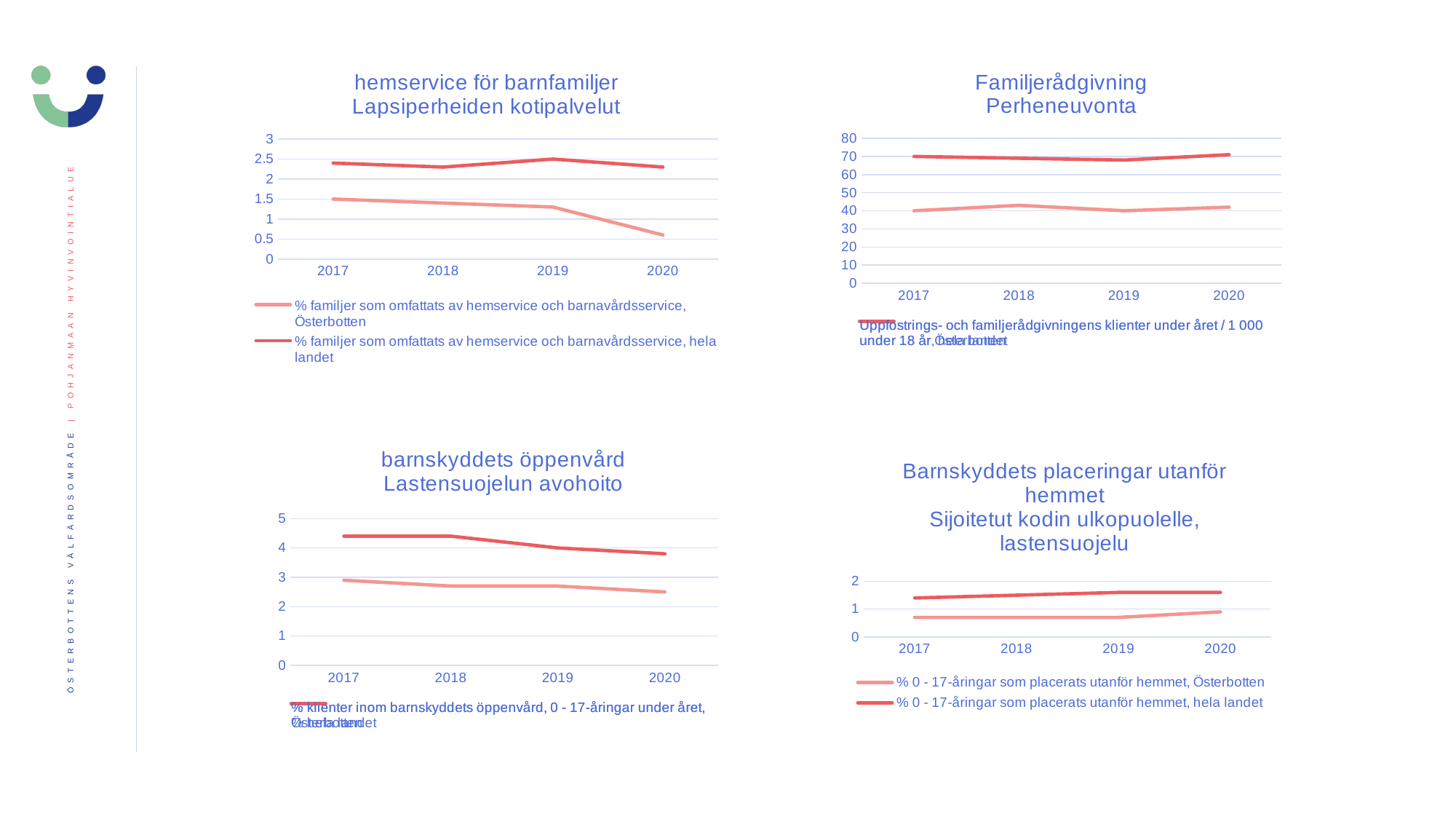
In the 'hemservice för barnfamiljer / Lapsiperheiden kotipalvelut' chart, does the Österbotten series rise or fall from 2017 to 2020? fall In the 'Familjerådgivning / Perheneuvonta' chart, is the value of the lower (light red) line for 2019 greater or less than 50? less What kind of chart is the 'hemservice för barnfamiljer / Lapsiperheiden kotipalvelut' chart? line chart How many series does the legend of the 'hemservice för barnfamiljer / Lapsiperheiden kotipalvelut' chart list? 2 In the 'Familjerådgivning / Perheneuvonta' chart, is the value of the upper (dark red) line for 2017 greater or less than 60? greater In the 'barnskyddets öppenvård / Lastensuojelun avohoito' chart, does the hela landet (dark red) series rise or fall from 2017 to 2020? fall In the 'hemservice för barnfamiljer / Lapsiperheiden kotipalvelut' chart, which year has the lowest value for Österbotten? 2020 In the 'barnskyddets öppenvård / Lastensuojelun avohoito' chart, is the hela landet (dark red) value for 2020 greater or less than 4? less In the 'hemservice för barnfamiljer / Lapsiperheiden kotipalvelut' chart, how many years are plotted on the x axis? 4 In the 'Barnskyddets placeringar utanför hemmet' chart, which series has the larger value in 2020, Österbotten or hela landet? hela landet